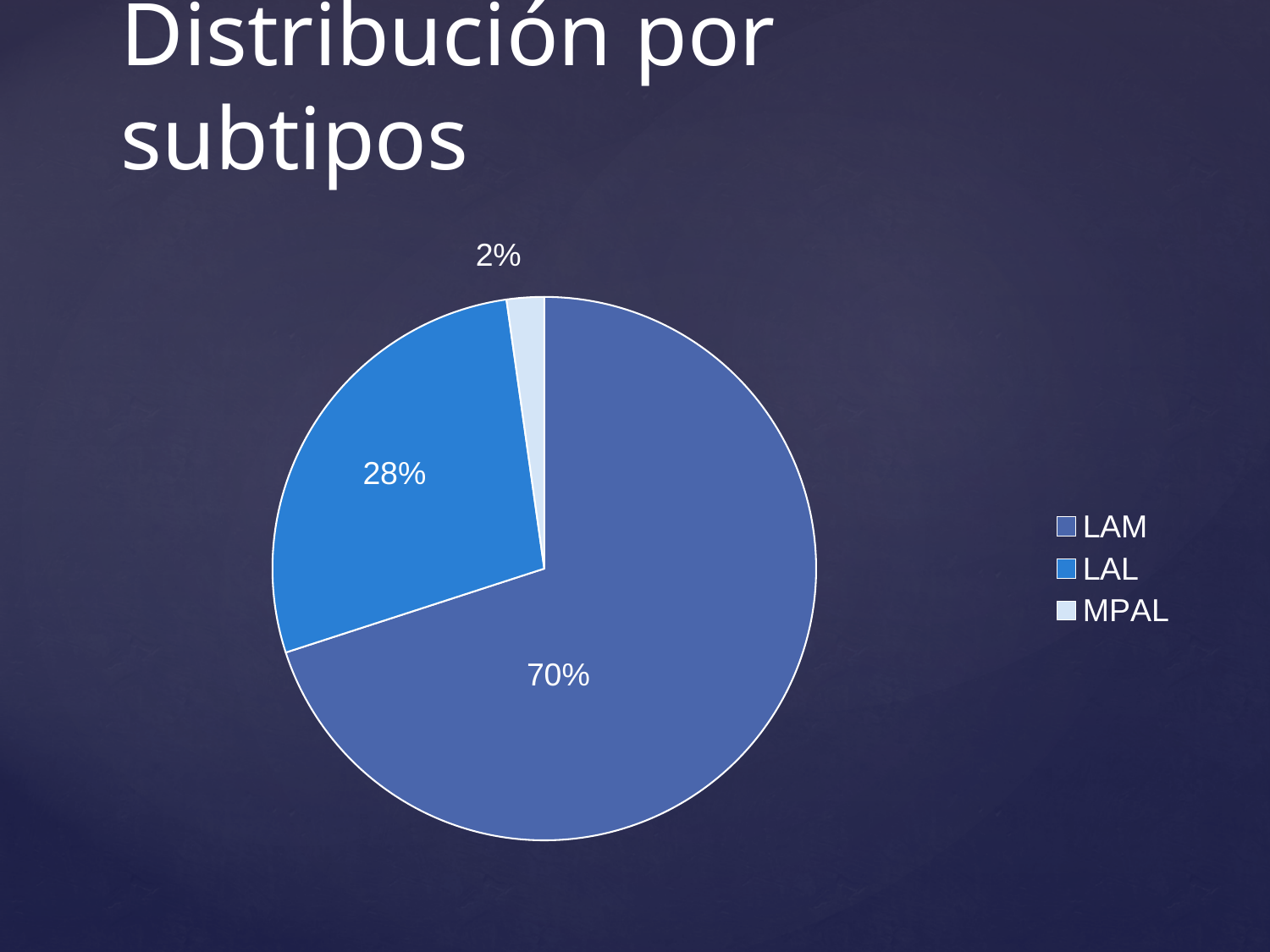
What share of the pie does LAM represent? 70% What kind of chart is shown on the slide? Pie chart Which subtype has the largest slice of the pie? LAM What share of the pie does LAL represent? 28% What is the title of the slide containing the chart? Distribución por subtipos Which is larger, the LAL slice or the MPAL slice? LAL Which subtype has the smallest slice of the pie? MPAL What is the difference in percentage points between the LAM and LAL slices? 42 How many categories are shown in the pie chart? 3 Which entries are listed in the chart's legend? LAM, LAL, MPAL What is the difference in percentage points between the LAL and MPAL slices? 26 What share of the pie does MPAL represent? 2%